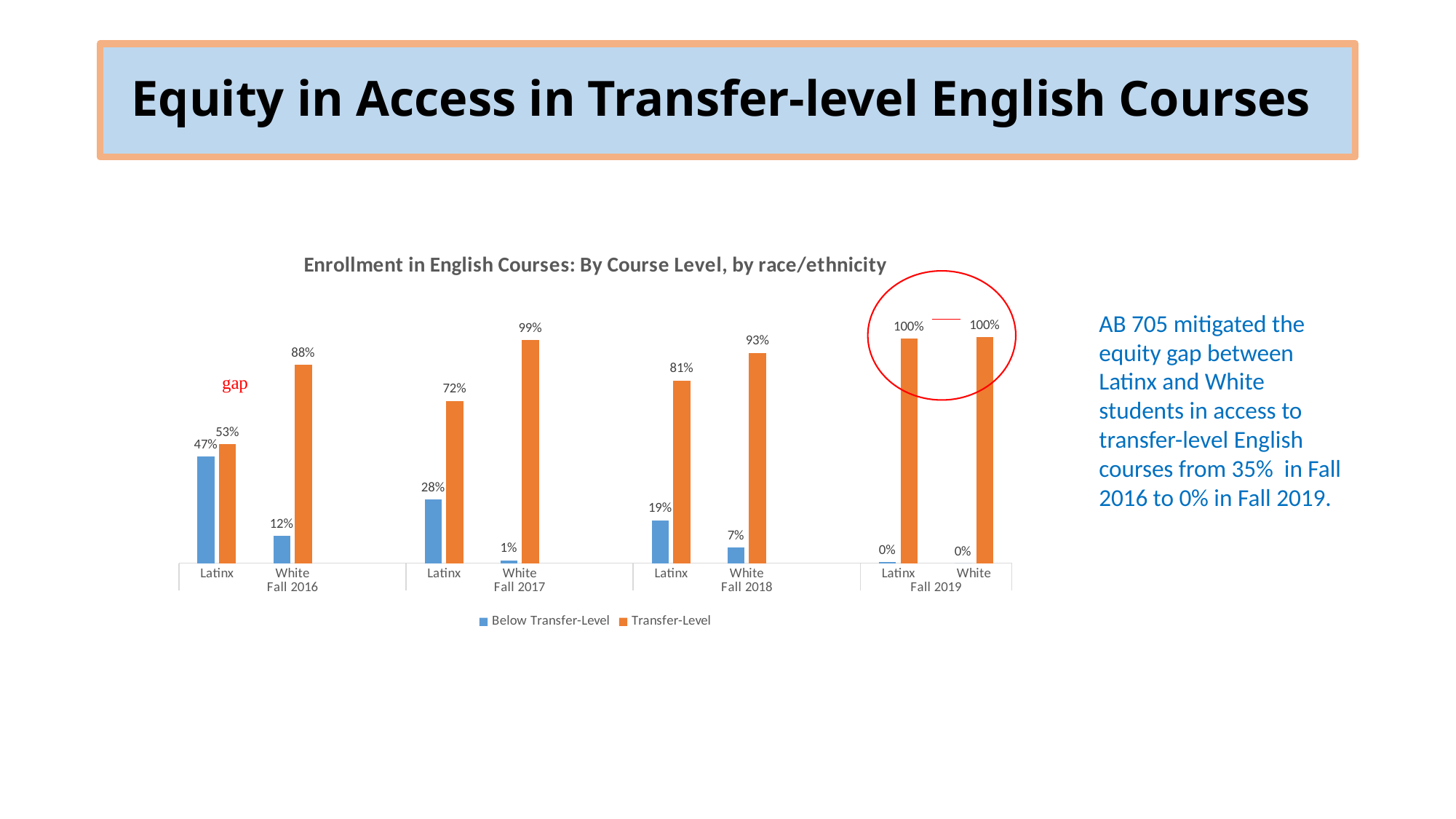
What is the Below Transfer-Level value for White students in Fall 2017? 1% Which is larger: the Transfer-Level value for Latinx students in Fall 2018 or for Latinx students in Fall 2017? Latinx, Fall 2018 What kind of chart is shown on the slide? Bar chart What is the difference between the Transfer-Level values for White and Latinx students in Fall 2017? 27% What is the Transfer-Level value for Latinx students in Fall 2016? 53% Does the Transfer-Level value for Latinx students rise or fall from Fall 2016 to Fall 2019? Rise Which group and term has the highest Below Transfer-Level value? Latinx, Fall 2016 How many series does the legend list? 2 What is the title of the chart? Enrollment in English Courses: By Course Level, by race/ethnicity What is the Transfer-Level value for White students in Fall 2018? 93% What is the Below Transfer-Level value for Latinx students in Fall 2018? 19% What is the difference between the Transfer-Level values for White and Latinx students in Fall 2016? 35%